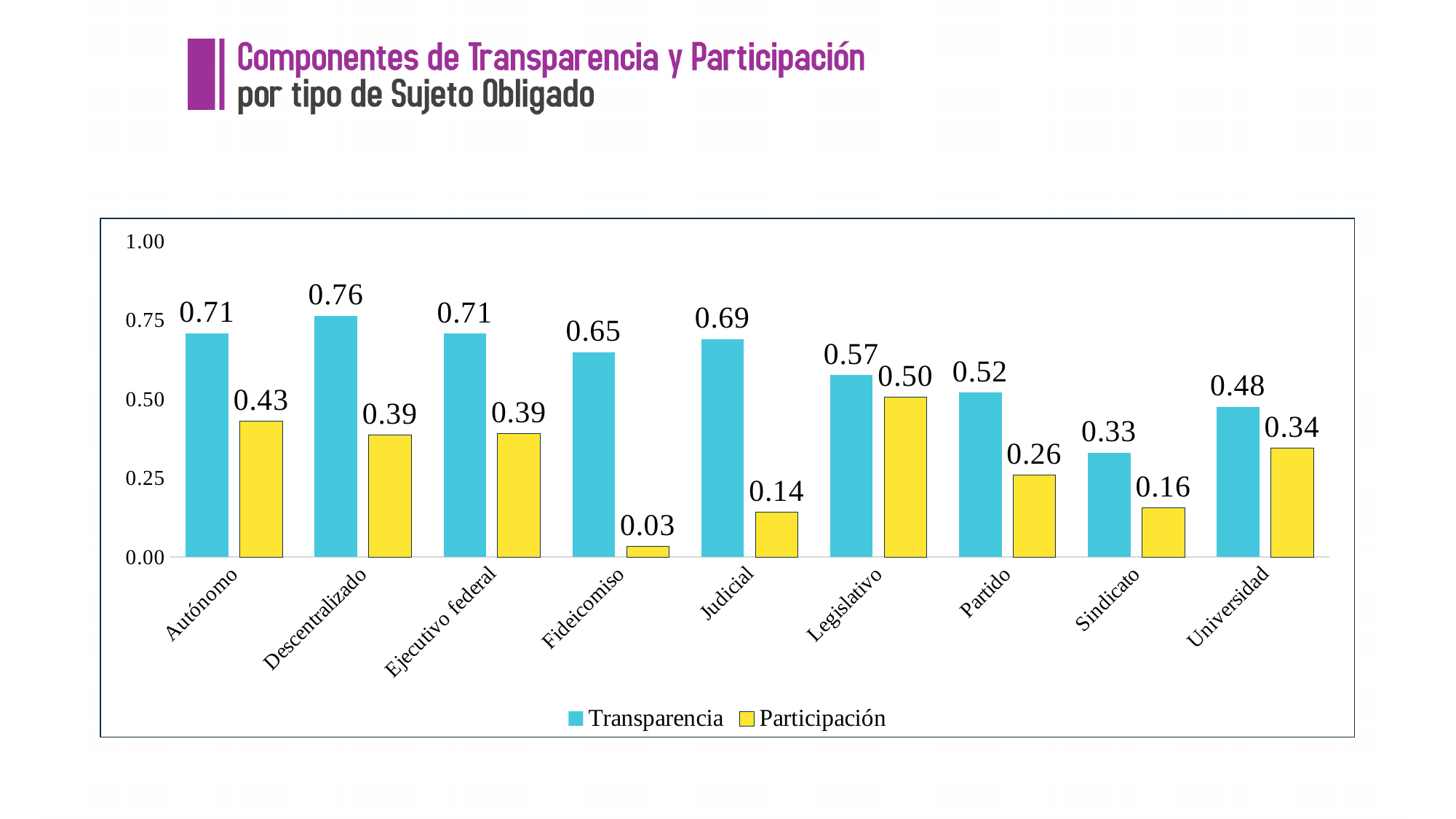
Which category has the lowest Participación value? Fideicomiso What is the Participación value for Legislativo? 0.50 Which category has the highest Transparencia value? Descentralizado What kind of chart is shown on the slide? Bar chart How many categories are shown on the x axis? 9 Which colour represents the Participación series? Yellow What is the difference between the Transparencia and Participación values for Judicial? 0.55 Which category has the lowest Transparencia value? Sindicato Which is larger for Universidad: the Transparencia value or the Participación value? Transparencia How many series does the legend list? 2 What is the Participación value for Fideicomiso? 0.03 What is the Transparencia value for Descentralizado? 0.76